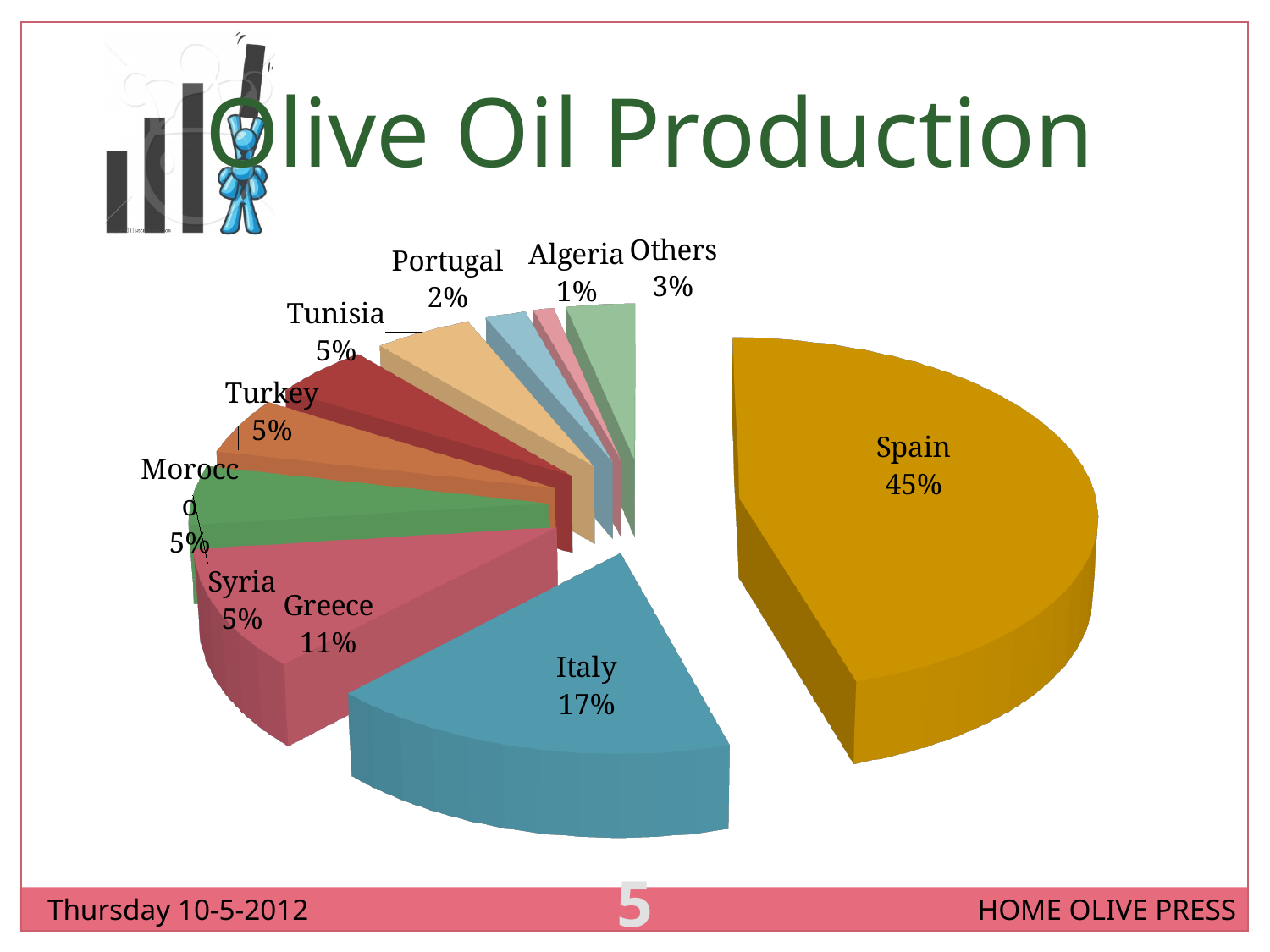
Which country has the largest share of olive oil production? Spain What is the difference in percentage points between Spain's and Italy's shares? 28 What share of olive oil production does Algeria have? 1% What share of olive oil production does Italy have? 17% Which has a larger share of olive oil production, Greece or Italy? Italy What is the title of the slide containing the pie chart? Olive Oil Production How many slices does the pie chart have? 10 Which labelled slice has the smallest share of olive oil production? Algeria What share of olive oil production does Greece have? 11% What share of olive oil production does Spain have? 45% What kind of chart is shown on the slide? Pie chart What share of olive oil production does Portugal have? 2%